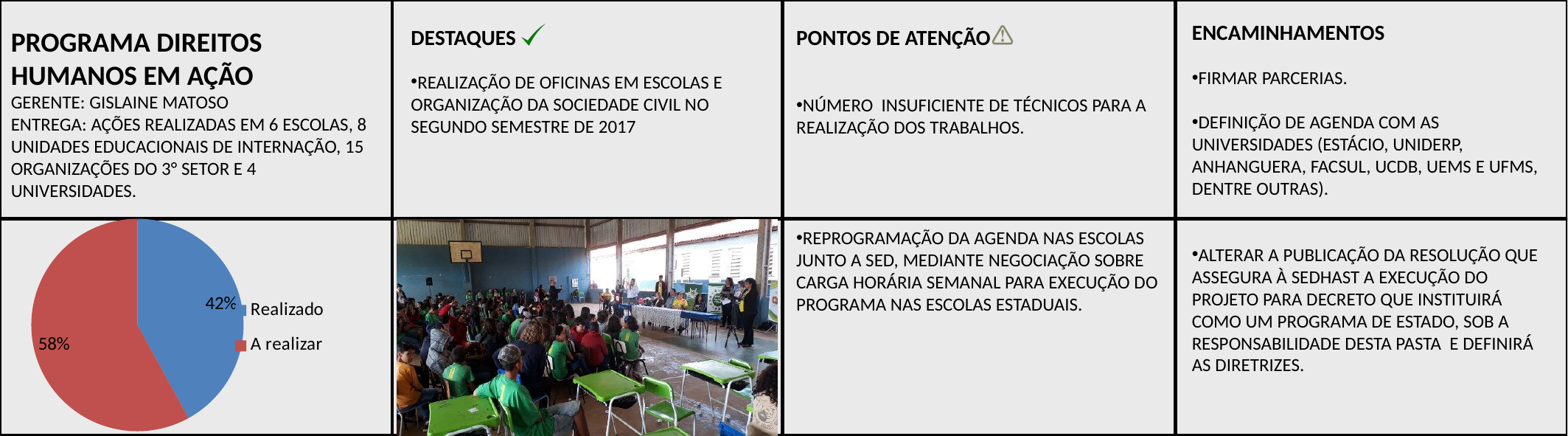
What share of the pie does "A realizar" represent? 58% What colour is the "Realizado" slice? blue What is the difference in percentage points between "A realizar" and "Realizado"? 16 What colour is the "A realizar" slice? red How many entries does the legend list? 2 What share of the pie does "Realizado" represent? 42% Is the share for "Realizado" greater or less than 50%? less Which slice of the pie is the smallest? Realizado How many slices does the pie chart have? 2 Which slice of the pie is the largest? A realizar What kind of chart is shown on the slide? pie chart Which is larger, "Realizado" or "A realizar"? A realizar